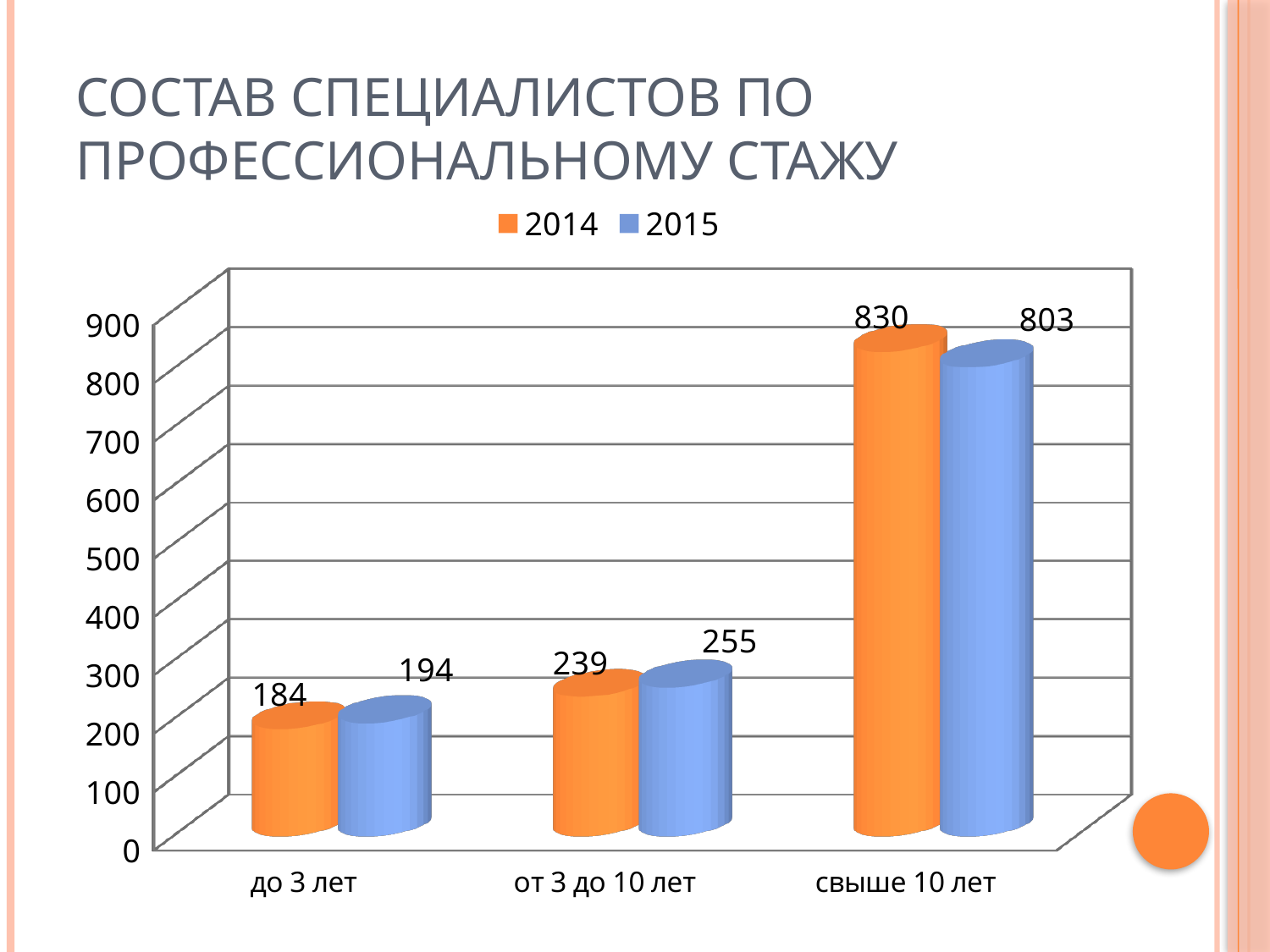
Which category has the highest value for 2015? свыше 10 лет What is the value for 2014 in the 'свыше 10 лет' category? 830 Which is larger in the 'от 3 до 10 лет' category: the 2014 value or the 2015 value? 2015 What is the difference between the 2014 and 2015 values in the 'свыше 10 лет' category? 27 Which category has the lowest value for 2014? до 3 лет What is the difference between the 2015 and 2014 values in the 'до 3 лет' category? 10 How many series does the legend list? 2 What is the value for 2014 in the 'до 3 лет' category? 184 What is the value for 2015 in the 'от 3 до 10 лет' category? 255 How many categories are shown on the x axis? 3 What kind of chart is shown on the slide? bar chart What is the value for 2015 in the 'свыше 10 лет' category? 803